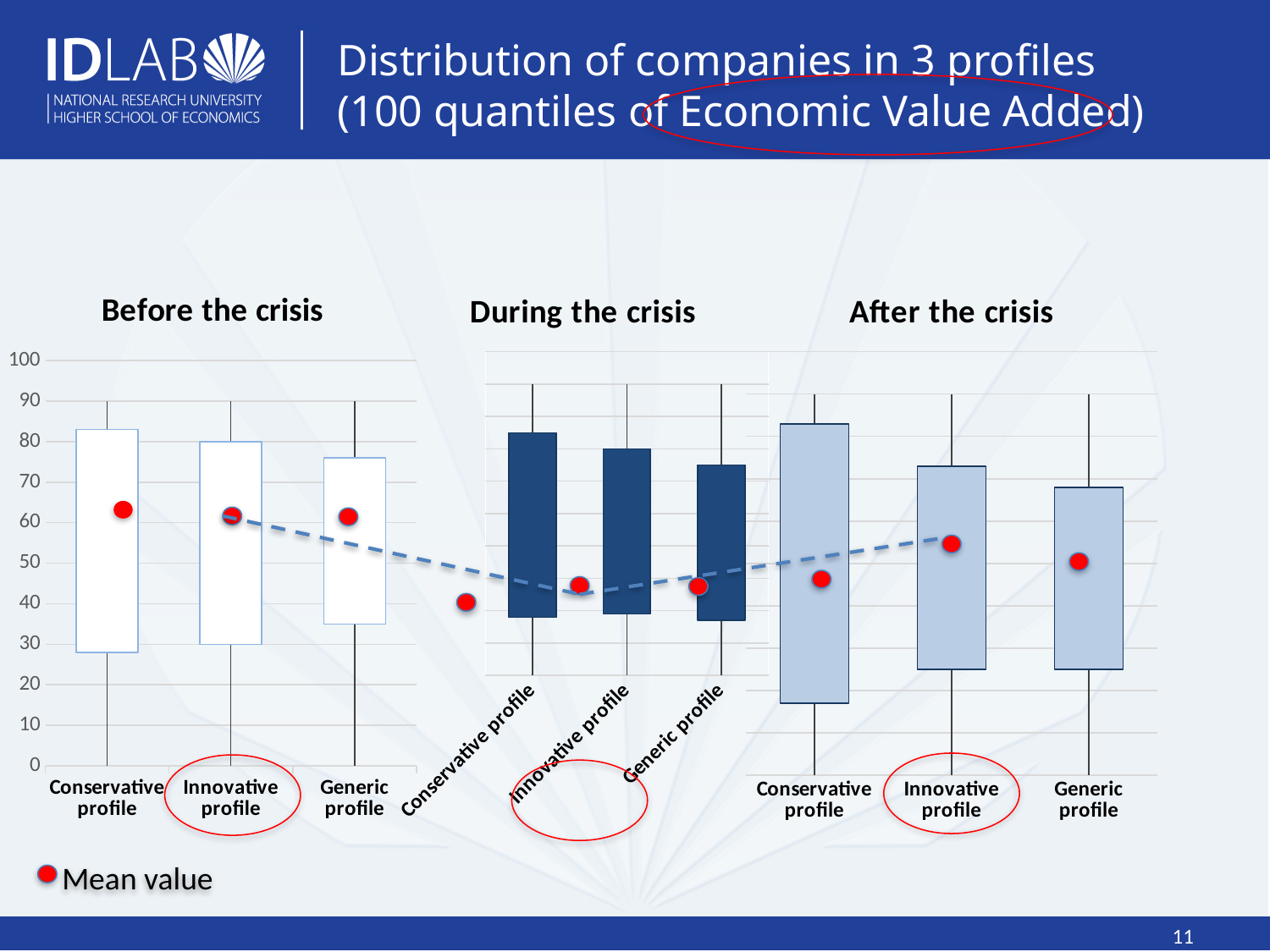
Is the mean value for the Conservative profile larger in the 'Before the crisis' chart or in the 'During the crisis' chart? Before the crisis In the 'During the crisis' chart, is the mean value for the Conservative profile greater or less than 50? less In the 'After the crisis' chart, is the mean value for the Conservative profile greater or less than 60? less What kind of chart is the 'During the crisis' chart? Box plot In the 'Before the crisis' chart, how many profile categories are shown on the x axis? 3 In the 'After the crisis' chart, which profile has the highest mean value? Innovative profile What does the red dot marker represent according to the legend on the slide? Mean value In the 'After the crisis' chart, is the mean value larger for the Innovative profile or the Conservative profile? Innovative profile In the 'Before the crisis' chart, is the mean value for the Innovative profile greater or less than 50? greater In the 'During the crisis' chart, which profile has the lowest mean value? Conservative profile How many charts are shown on the slide? 3